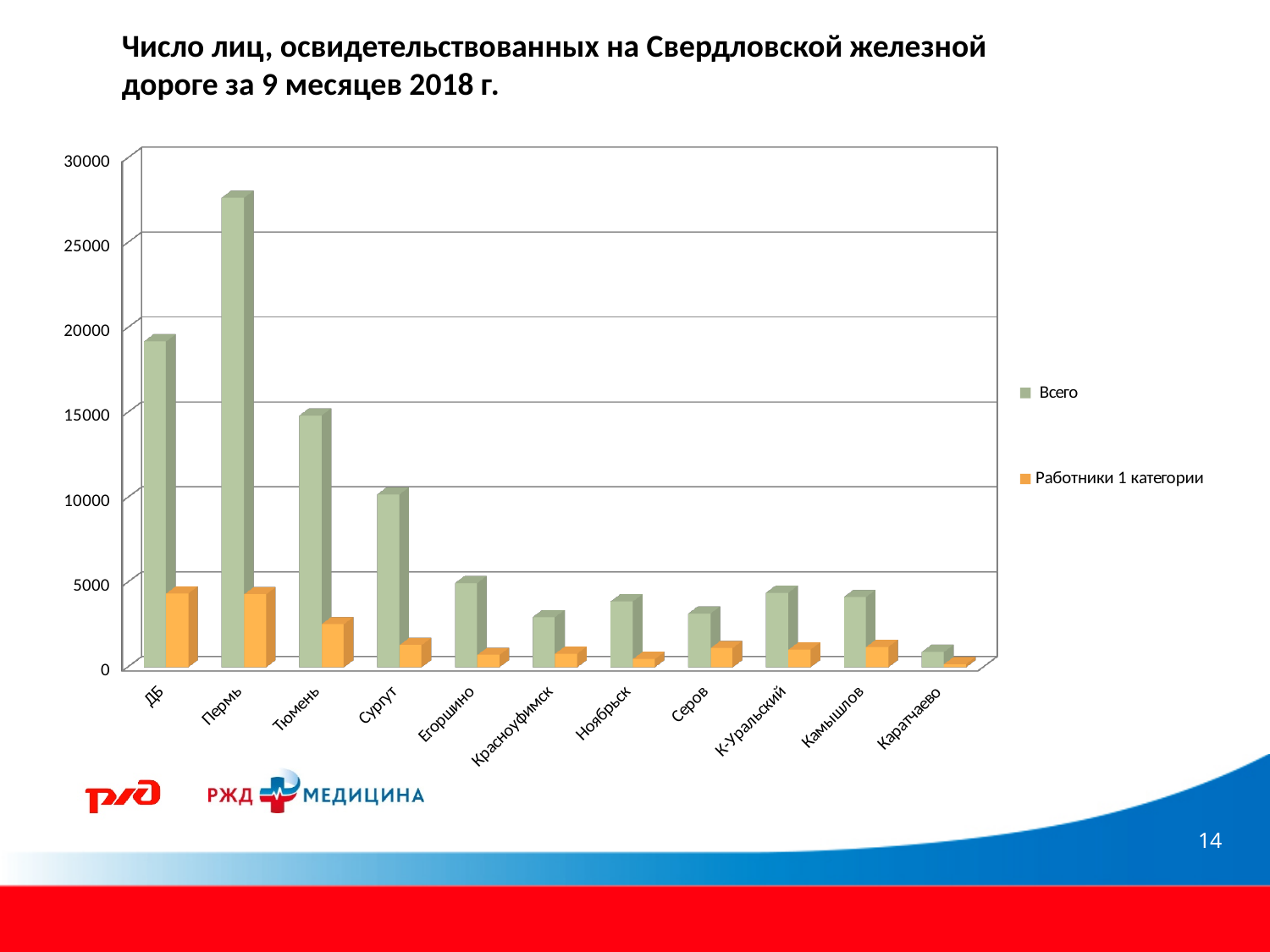
What are the two series named in the legend? Всего; Работники 1 категории What kind of chart is shown on the slide? bar chart Is the value for Работники 1 категории at ДБ greater or less than 10000? less Which category has the highest value for Всего? Пермь Is the value for Всего at Пермь greater or less than 25000? greater Which category has the lowest value for Всего? Каратчаево How many categories are shown on the x axis? 11 Is the value for Всего at Красноуфимск greater or less than 5000? less Which is larger for Всего: Тюмень or Сургут? Тюмень Which is larger for Всего: Пермь or ДБ? Пермь How many series does the legend list? 2